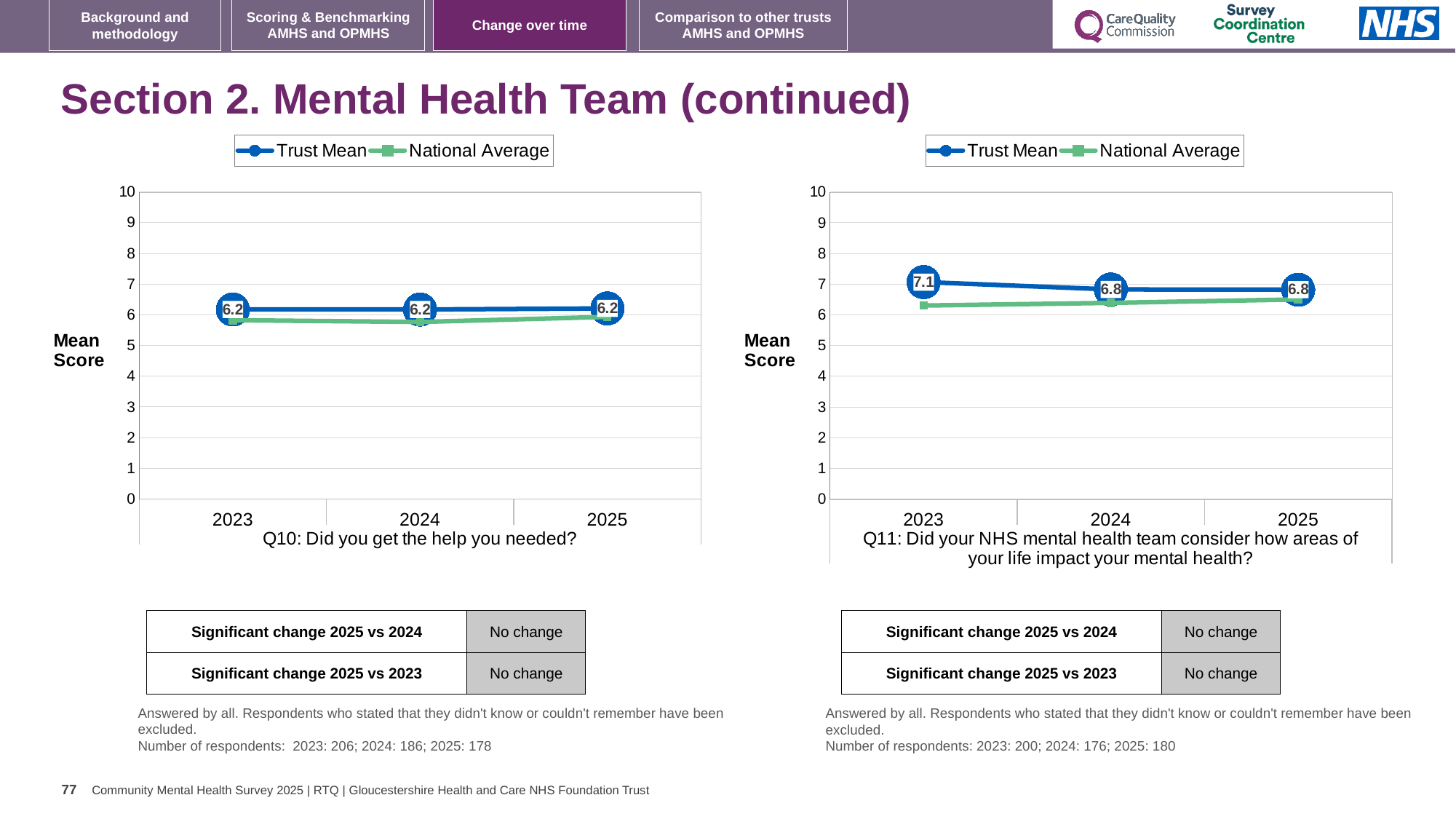
In the Q11 chart, which is larger in 2023: the Trust Mean or the National Average? Trust Mean In the Q11 chart, is the National Average value for 2023 greater or less than 7? less How many series does the legend of the Q11 chart list? 2 In the Q10 chart, what is the Trust Mean value for 2023? 6.2 How many years are plotted on the x axis of the Q10 chart? 3 In the Q11 chart, what is the Trust Mean value for 2023? 7.1 In the Q11 chart, what is the difference between the Trust Mean for 2023 and the Trust Mean for 2024? 0.3 In the Q11 chart, does the Trust Mean rise or fall from 2023 to 2024? Fall In the Q11 chart, which year has the highest Trust Mean? 2023 In the Q11 chart, what is the Trust Mean value for 2025? 6.8 What kind of chart is the Q10 chart? Line chart In the Q10 chart, is the National Average value for 2024 greater or less than 7? less